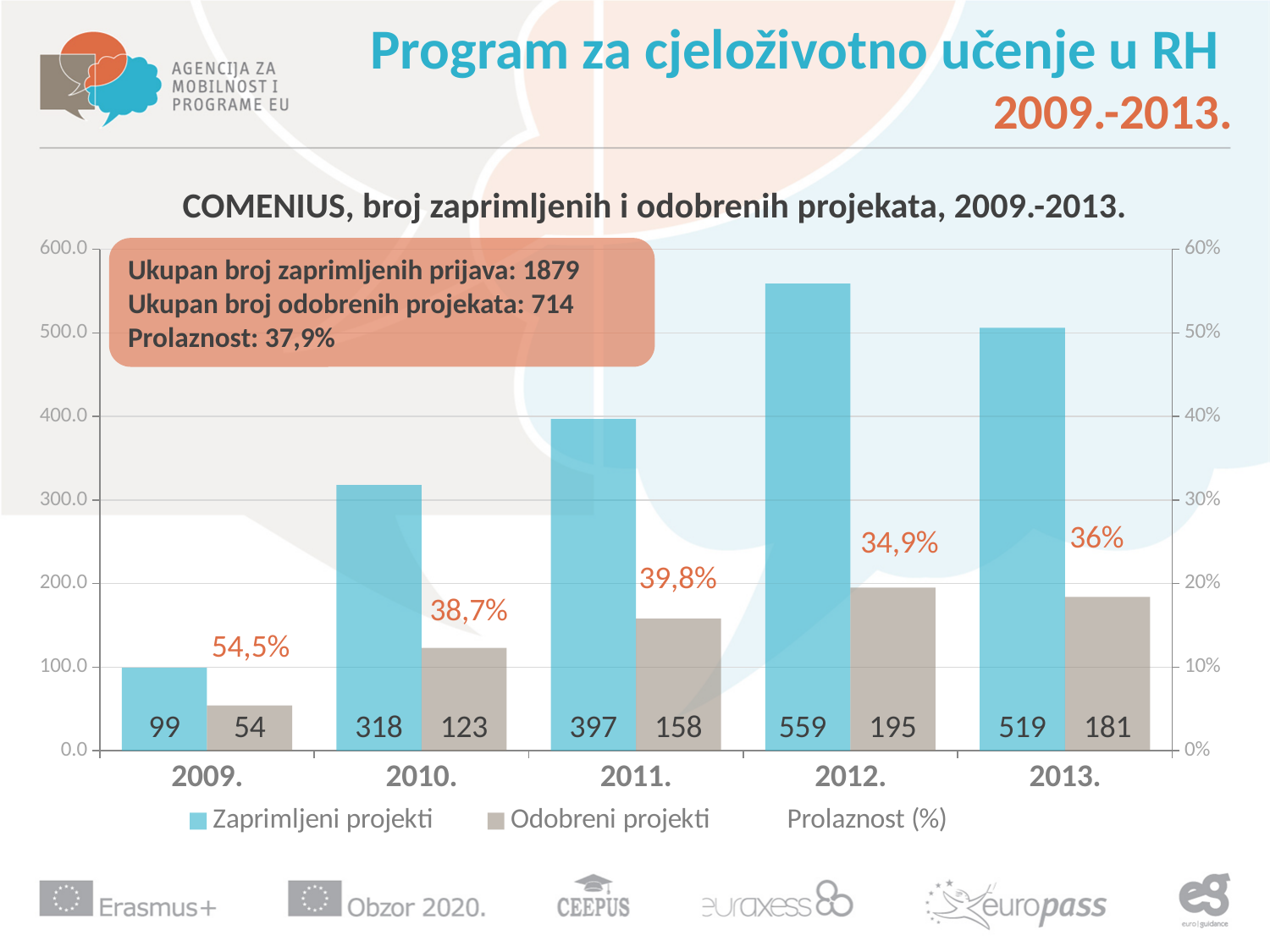
Which is larger: Zaprimljeni projekti in 2011. or Zaprimljeni projekti in 2013.? Zaprimljeni projekti in 2013. What kind of chart is used to show Zaprimljeni projekti and Odobreni projekti? bar chart Does the Prolaznost (%) value rise or fall from 2009. to 2010.? fall According to the text box on the chart, what is the Ukupan broj odobrenih projekata? 714 What is the value of Zaprimljeni projekti for 2012.? 559 What is the Prolaznost (%) value shown for 2011.? 39,8% What is the value of Odobreni projekti for 2010.? 123 What is the difference between Zaprimljeni projekti and Odobreni projekti in 2013.? 338 Which year has the lowest value for Odobreni projekti? 2009. Which year has the highest value for Zaprimljeni projekti? 2012. How many years are shown on the x axis? 5 How many series does the legend list? 3